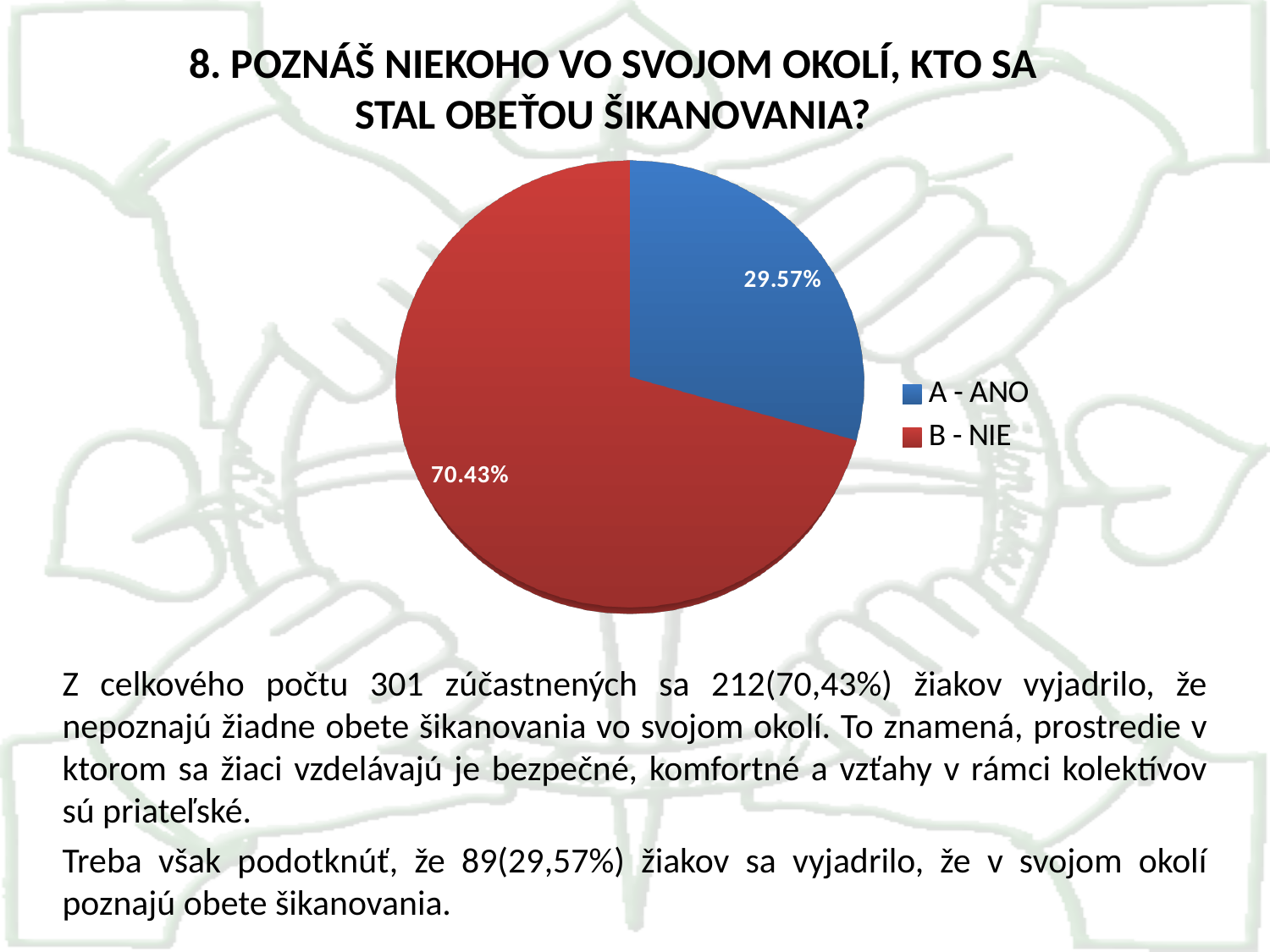
What share of the pie does the B - NIE slice take? 70.43% How many slices does the pie chart have? 2 What colour is the slice for B - NIE? red What percentage is shown for the slice labelled B - NIE? 70.43% What is the difference in percentage points between the B - NIE slice and the A - ANO slice? 40.86 What kind of chart is shown on the slide? pie chart What colour is the slice for A - ANO? blue Which slice of the pie is the largest? B - NIE Which slice of the pie is the smallest? A - ANO How many entries does the legend list? 2 Which is larger, the slice for A - ANO or the slice for B - NIE? B - NIE What percentage is shown for the slice labelled A - ANO? 29.57%